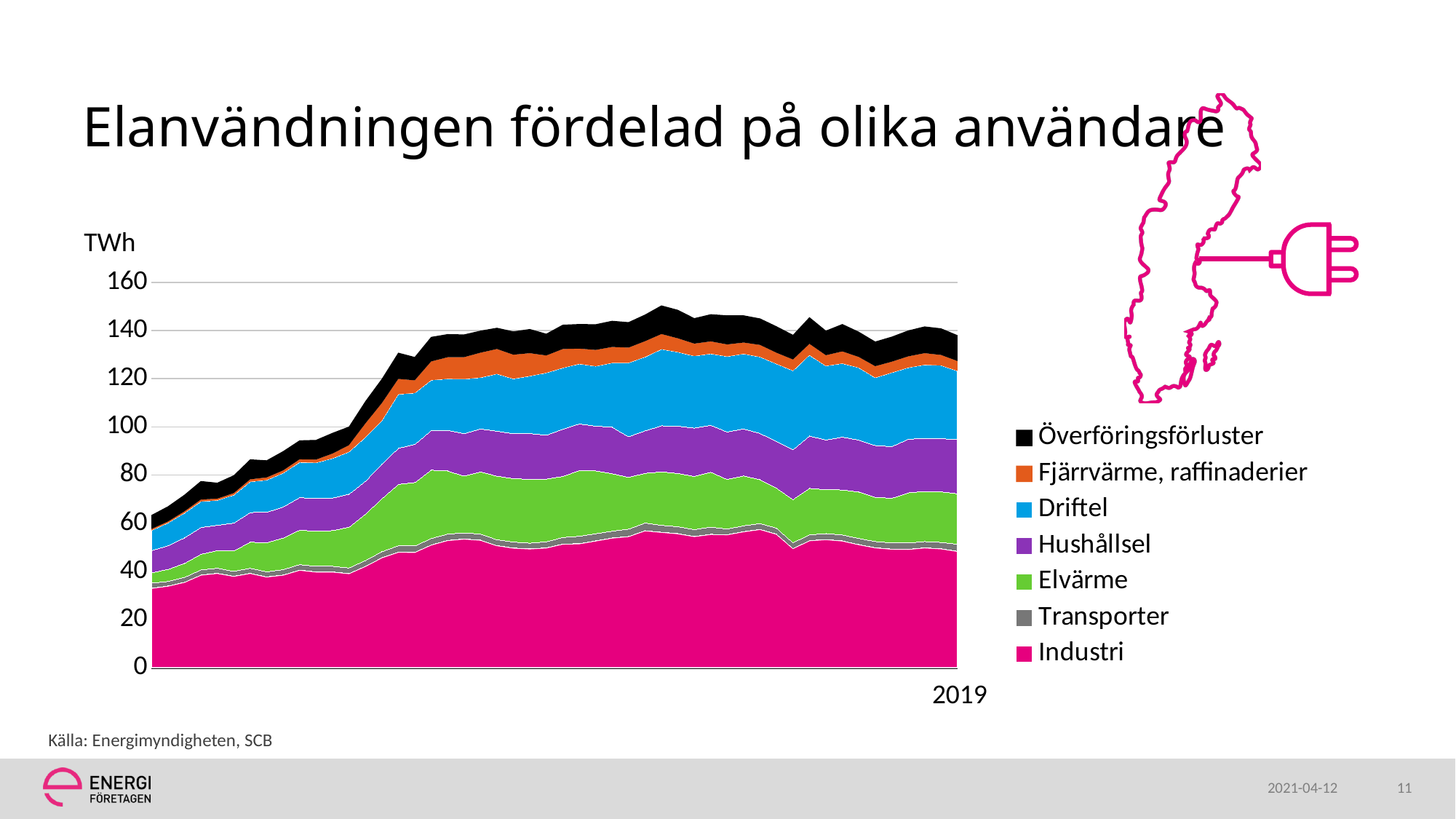
Which series accounts for the smallest share of electricity use in the chart? Transporter Is the total electricity use in 2019 greater or less than 120 TWh? greater How does total electricity use develop along the x axis from the start of the series to 2019? It rises strongly at first, then levels off Is the total electricity use in 2019 greater or less than 160 TWh? less Is the value for Industri in 2019 greater or less than 60 TWh? less Which series is larger in 2019, Industri or Transporter? Industri How many series does the legend list? 7 Which series accounts for the largest share of electricity use throughout the chart? Industri What kind of chart is shown on the slide? Stacked area chart What unit is shown on the y axis of the chart? TWh What is the title of the chart? Elanvändningen fördelad på olika användare